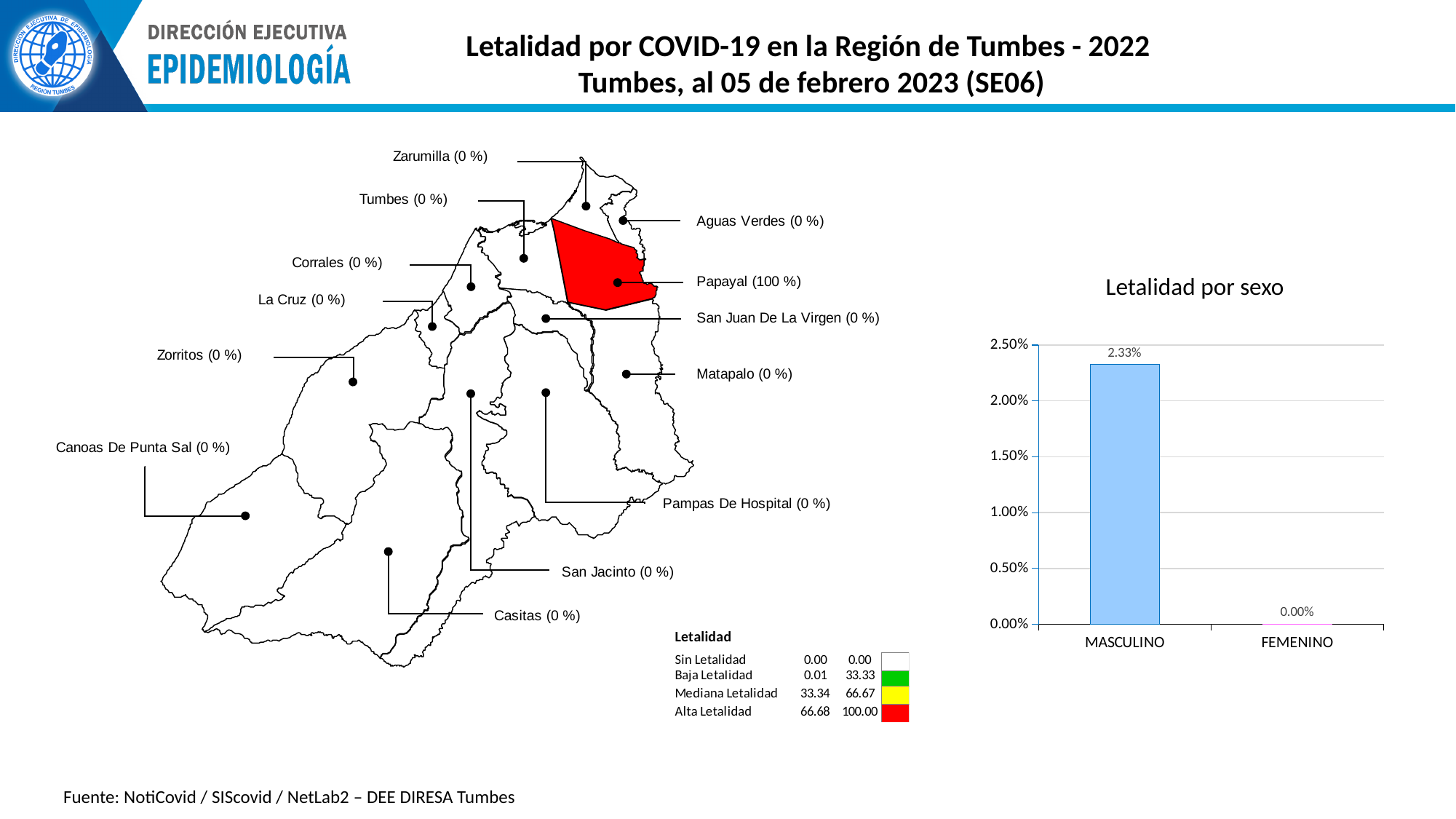
In the 'Letalidad por sexo' chart, what is the value for MASCULINO? 2.33% What is the highest tick value shown on the y axis of the 'Letalidad por sexo' chart? 2.50% In the 'Letalidad por sexo' chart, what is the value for FEMENINO? 0.00% In the 'Letalidad por sexo' chart, which category has the lowest value? FEMENINO In the 'Letalidad por sexo' chart, which is larger, the value for MASCULINO or for FEMENINO? MASCULINO How many categories are shown on the x axis of the 'Letalidad por sexo' chart? 2 In the 'Letalidad por sexo' chart, what is the difference between the MASCULINO and FEMENINO values? 2.33% What is the title of the chart on the right side of the slide? Letalidad por sexo What kind of chart is 'Letalidad por sexo'? bar chart In the 'Letalidad por sexo' chart, is the value for MASCULINO greater or less than 2.00%? greater In the 'Letalidad por sexo' chart, which category has the highest value? MASCULINO On the map on the left of the slide, what lethality value is shown for Papayal? 100 %